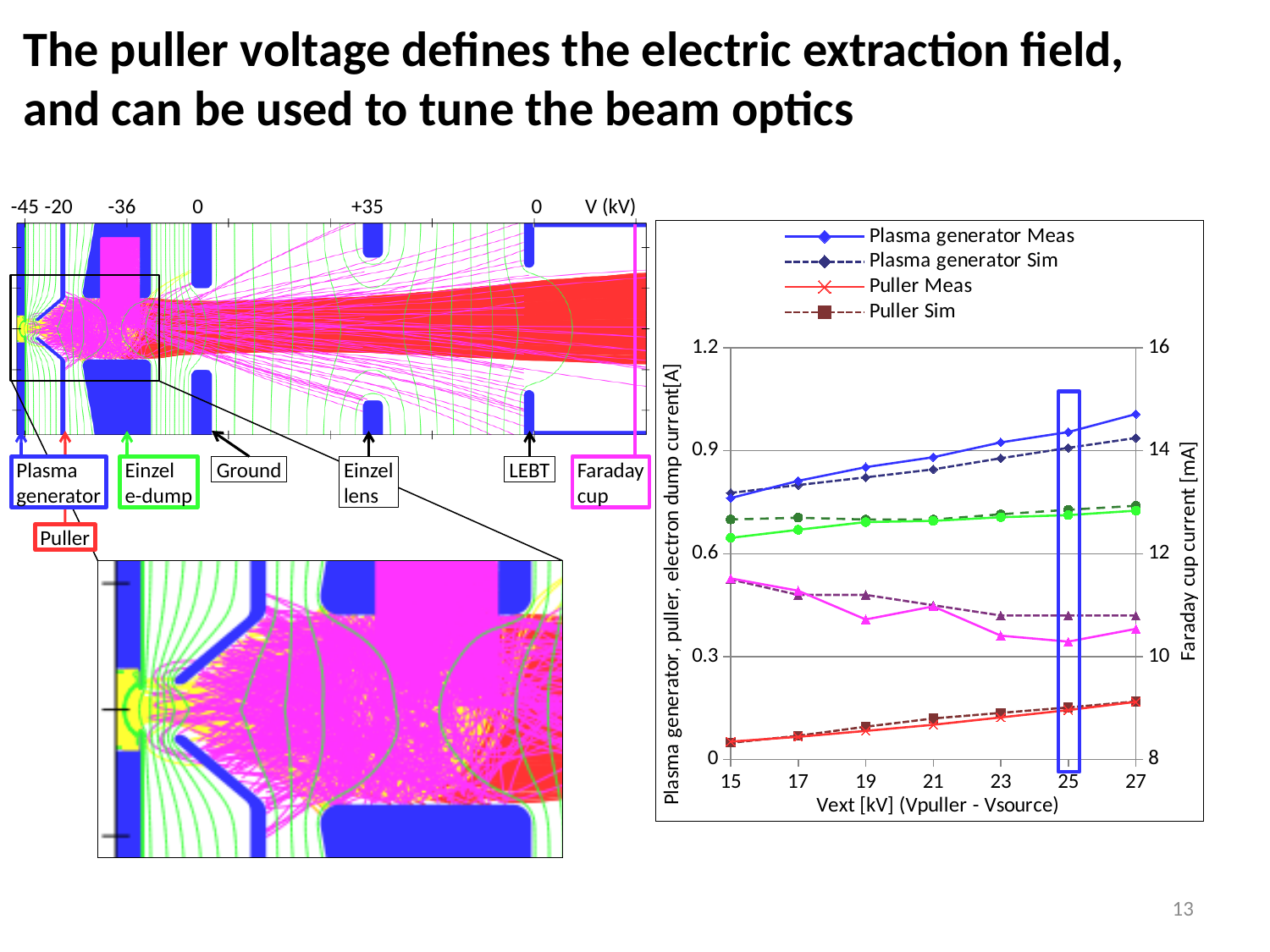
How many series does the chart legend list? 4 Is the Plasma generator Meas value at Vext = 27 kV greater or less than 0.9 on the left axis? greater What kind of chart is shown on the right of the slide? line chart What is the title of the x axis of the chart? Vext [kV] (Vpuller - Vsource) Does the Plasma generator Meas series rise or fall as Vext increases from 15 to 27 kV? rise Is the Puller Meas value at Vext = 27 kV greater or less than 0.3 on the left axis? less At Vext = 27 kV, which is larger: the Plasma generator Meas value or the Puller Meas value? Plasma generator Meas Is the Plasma generator Sim value at Vext = 19 kV greater or less than 0.9 on the left axis? less Does the Puller Meas series rise or fall as Vext increases from 15 to 27 kV? rise How many data points does the Plasma generator Meas series have? 7 Which legend series has the highest value at Vext = 27 kV? Plasma generator Meas